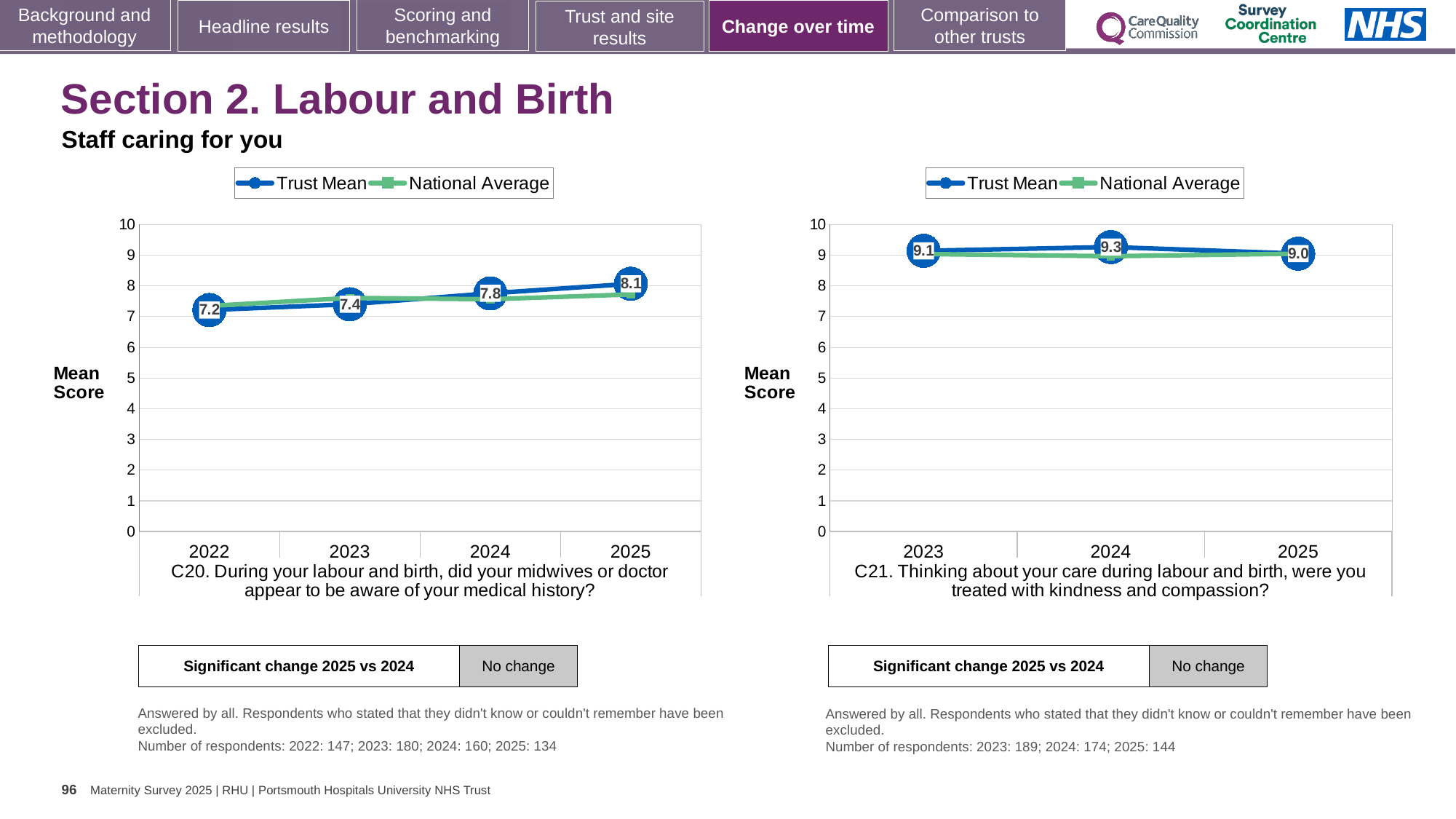
On the right chart (C21), is the Trust Mean for 2023 or 2024 higher? 2024 On the left chart (C20), what is the Trust Mean for 2025? 8.1 How many series does the legend of the right chart (C21) list? 2 On the left chart (C20), which year has the highest Trust Mean? 2025 How many years are plotted on the left chart (C20)? 4 On the left chart (C20), does the Trust Mean rise or fall from 2022 to 2025? rise On the right chart (C21), which year has the lowest Trust Mean? 2025 On the right chart (C21), what is the Trust Mean for 2024? 9.3 On the left chart (C20), what is the Trust Mean for 2022? 7.2 On the left chart (C20), is the National Average for 2025 greater or less than 7? greater On the left chart (C20), what is the difference between the Trust Mean for 2025 and 2022? 0.9 On the right chart (C21), what is the Trust Mean for 2025? 9.0